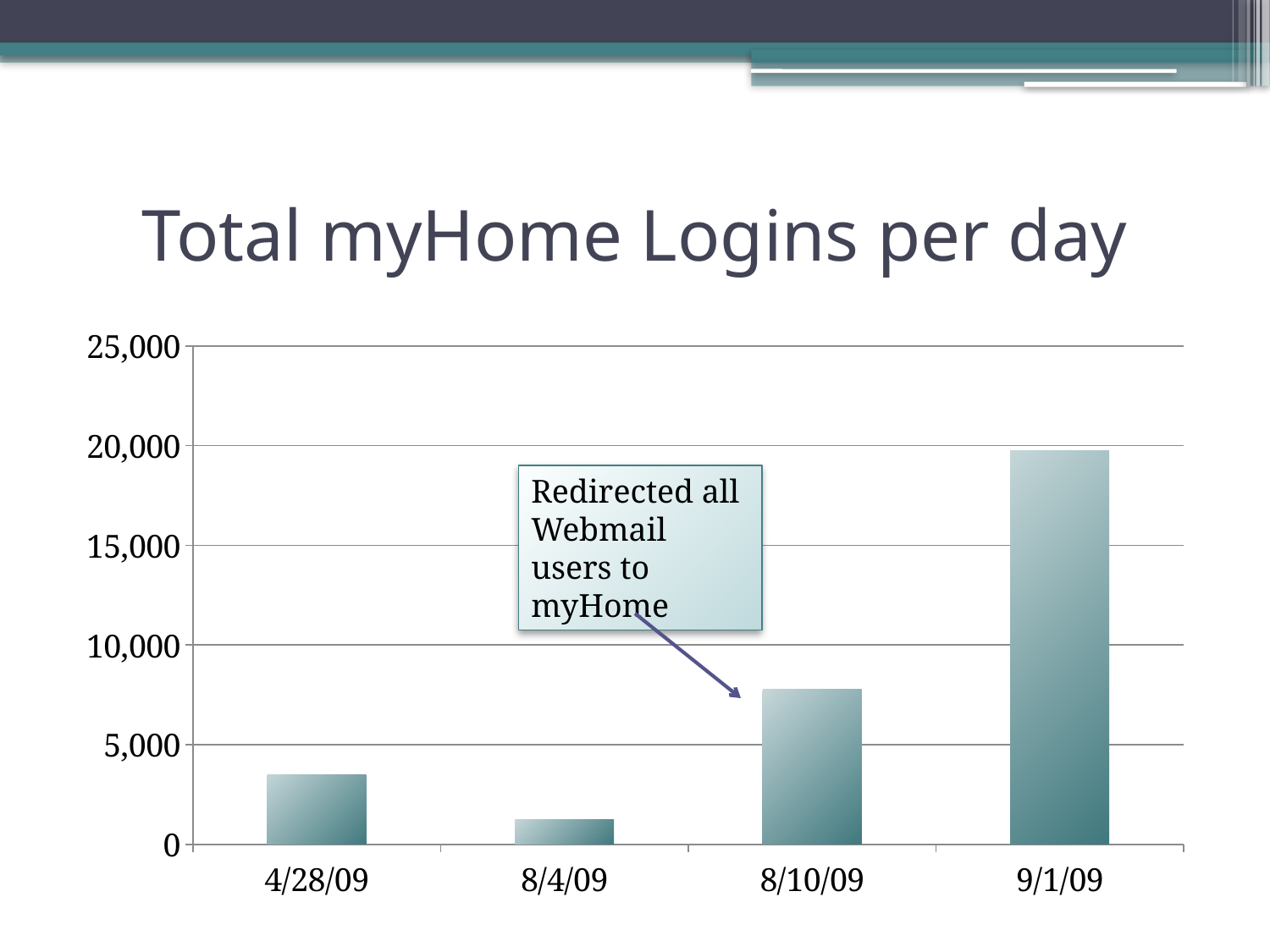
Which has more logins, 8/10/09 or 9/1/09? 9/1/09 Which date has the highest number of logins? 9/1/09 Is the value for 8/10/09 greater or less than 10,000? less What is the title of the chart? Total myHome Logins per day What type of chart is shown on the slide? bar chart Is the value for 9/1/09 greater or less than 15,000? greater Which date has the lowest number of logins? 8/4/09 What does the callout box pointing to the 8/10/09 bar say? Redirected all Webmail users to myHome How many dates are shown on the x axis of the chart? 4 Which has more logins, 4/28/09 or 8/4/09? 4/28/09 Is the value for 8/10/09 greater or less than 5,000? greater